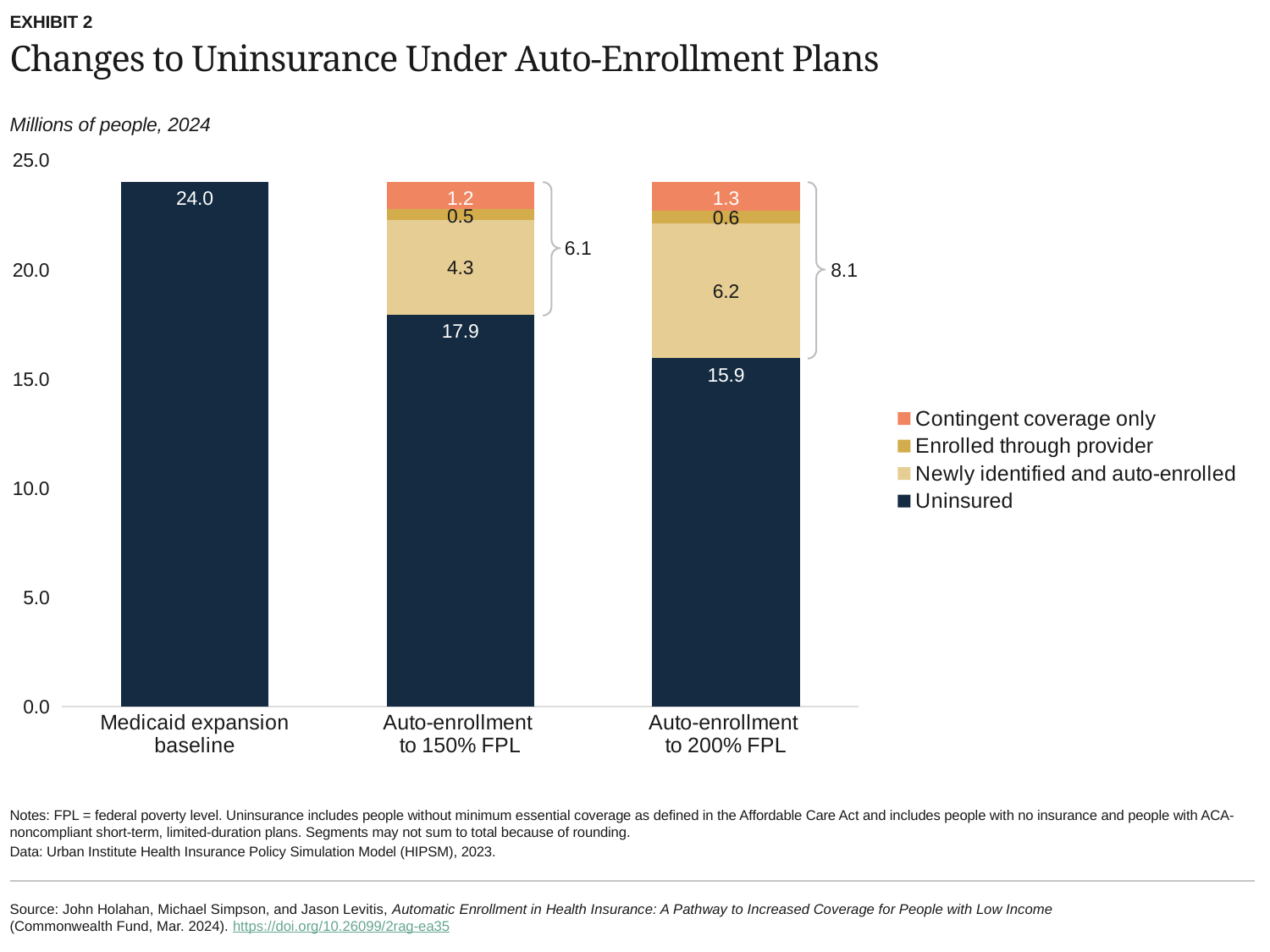
What is the Uninsured value for the Medicaid expansion baseline? 24.0 What is the difference in the Uninsured value between the Medicaid expansion baseline and Auto-enrollment to 200% FPL? 8.1 What is the difference in the Newly identified and auto-enrolled value between Auto-enrollment to 200% FPL and Auto-enrollment to 150% FPL? 1.9 How many series does the legend list? 4 Which is larger: the Uninsured value under Auto-enrollment to 150% FPL or under Auto-enrollment to 200% FPL? Auto-enrollment to 150% FPL What kind of chart is shown? Stacked bar chart What is the Contingent coverage only value under Auto-enrollment to 200% FPL? 1.3 What is the Newly identified and auto-enrolled value under Auto-enrollment to 150% FPL? 4.3 What is the Enrolled through provider value under Auto-enrollment to 150% FPL? 0.5 What is the Uninsured value under Auto-enrollment to 200% FPL? 15.9 Does the Uninsured value rise or fall from left to right across the categories? Fall Which category has the lowest Uninsured value? Auto-enrollment to 200% FPL